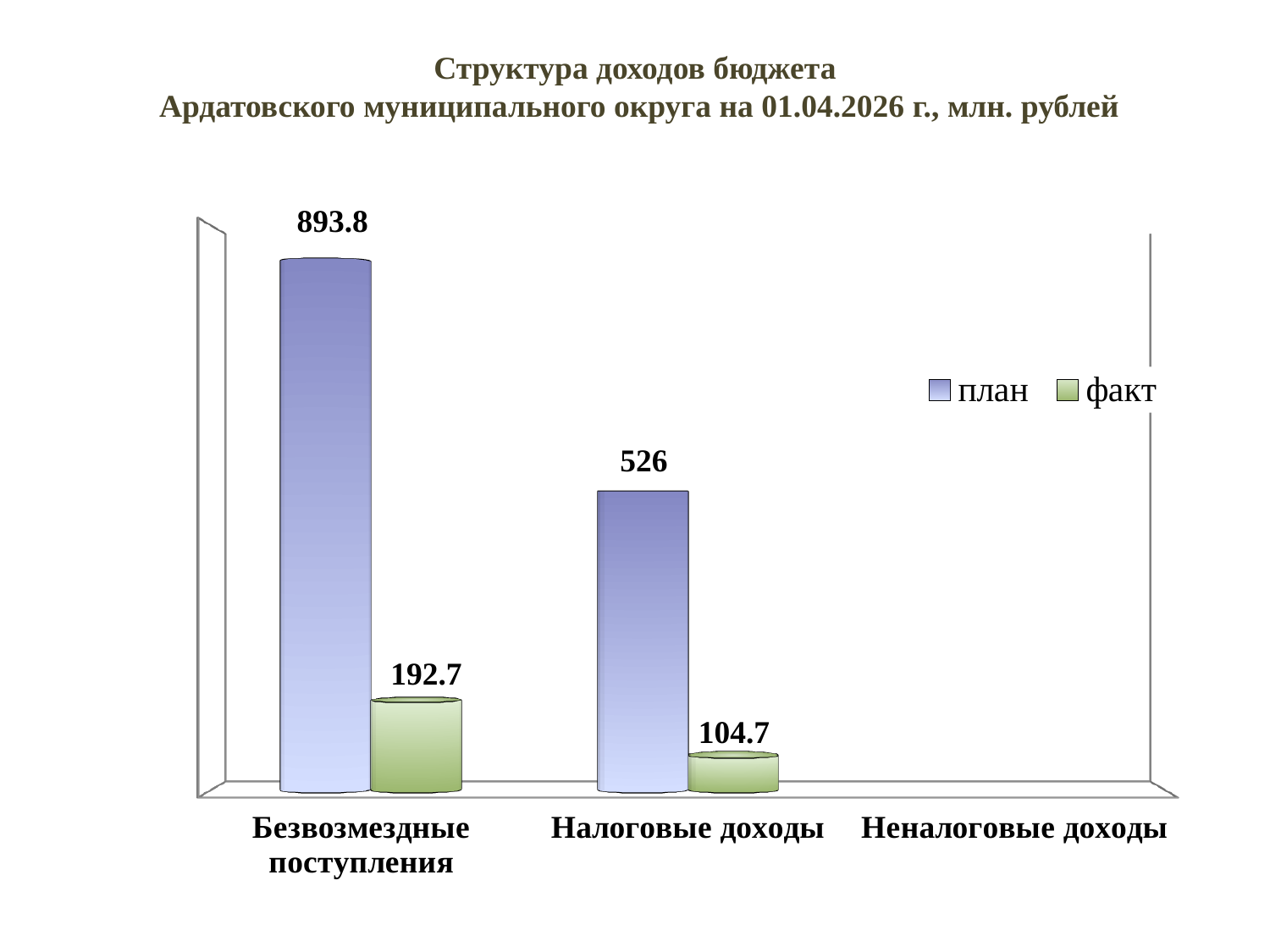
What is the difference between the план and факт values for Безвозмездные поступления? 701.1 What is the факт value for Налоговые доходы? 104.7 What is the план value for Налоговые доходы? 526 Which is larger: the факт value for Безвозмездные поступления or the факт value for Налоговые доходы? Безвозмездные поступления What are the two series named in the legend? план and факт Which category has the highest план value? Безвозмездные поступления What is the difference between the план values for Безвозмездные поступления and Налоговые доходы? 367.8 What kind of chart is shown on the slide? Bar chart What is the факт value for Безвозмездные поступления? 192.7 What is the план value for Безвозмездные поступления? 893.8 How many series does the legend list? 2 How many categories are shown on the x axis? 3